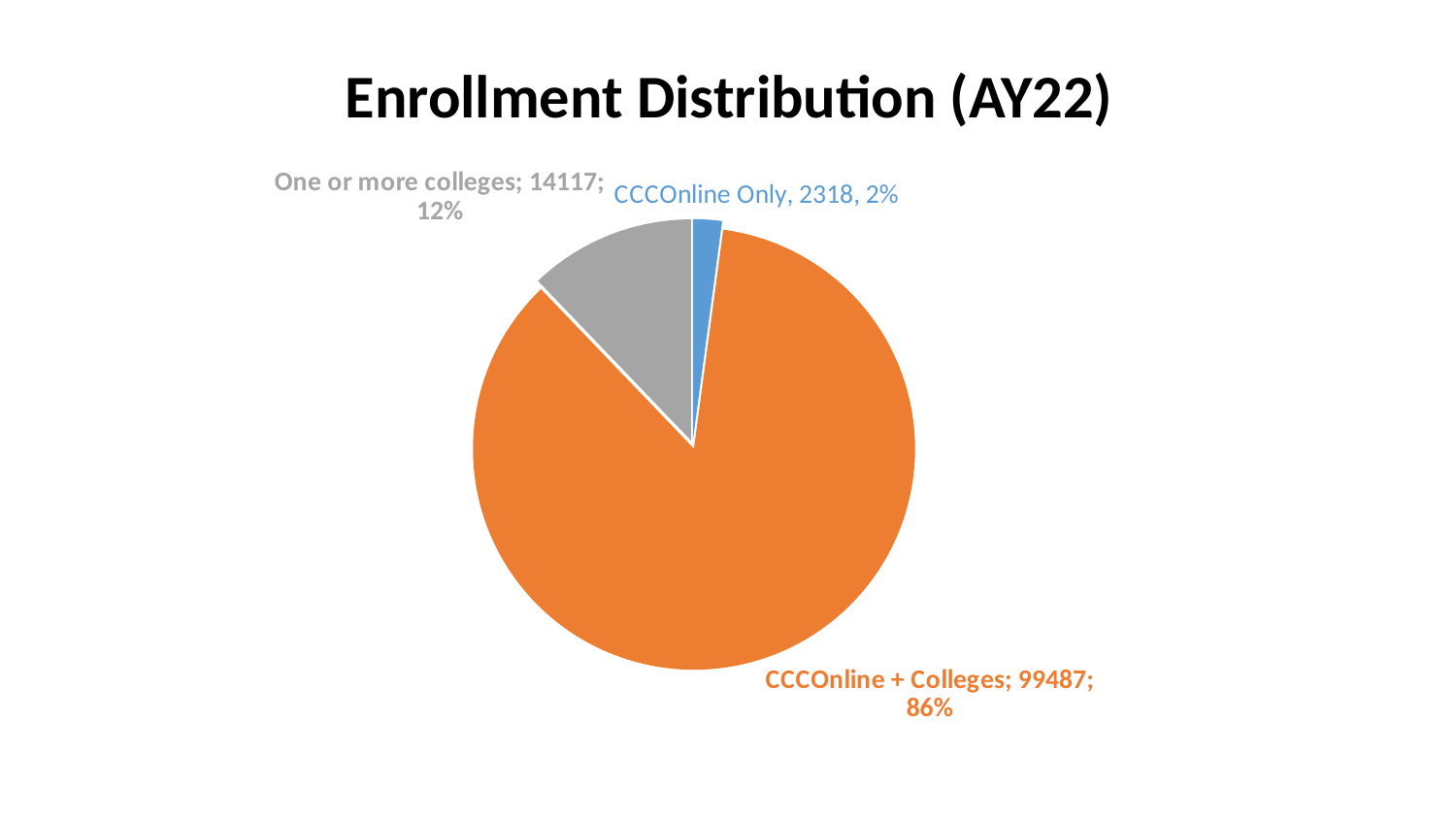
What is the difference in enrollment between One or more colleges and CCCOnline Only? 11799 What share of the pie does One or more colleges represent? 12% What is the title of the chart? Enrollment Distribution (AY22) What share of the pie does CCCOnline Only represent? 2% Which category has the largest slice? CCCOnline + Colleges How many slices does the pie chart have? 3 What is the enrollment value for CCCOnline + Colleges? 99487 What is the enrollment value for CCCOnline Only? 2318 What is the enrollment value for One or more colleges? 14117 What share of the pie does CCCOnline + Colleges represent? 86% Which category has the smallest slice? CCCOnline Only What type of chart is shown on the slide? pie chart